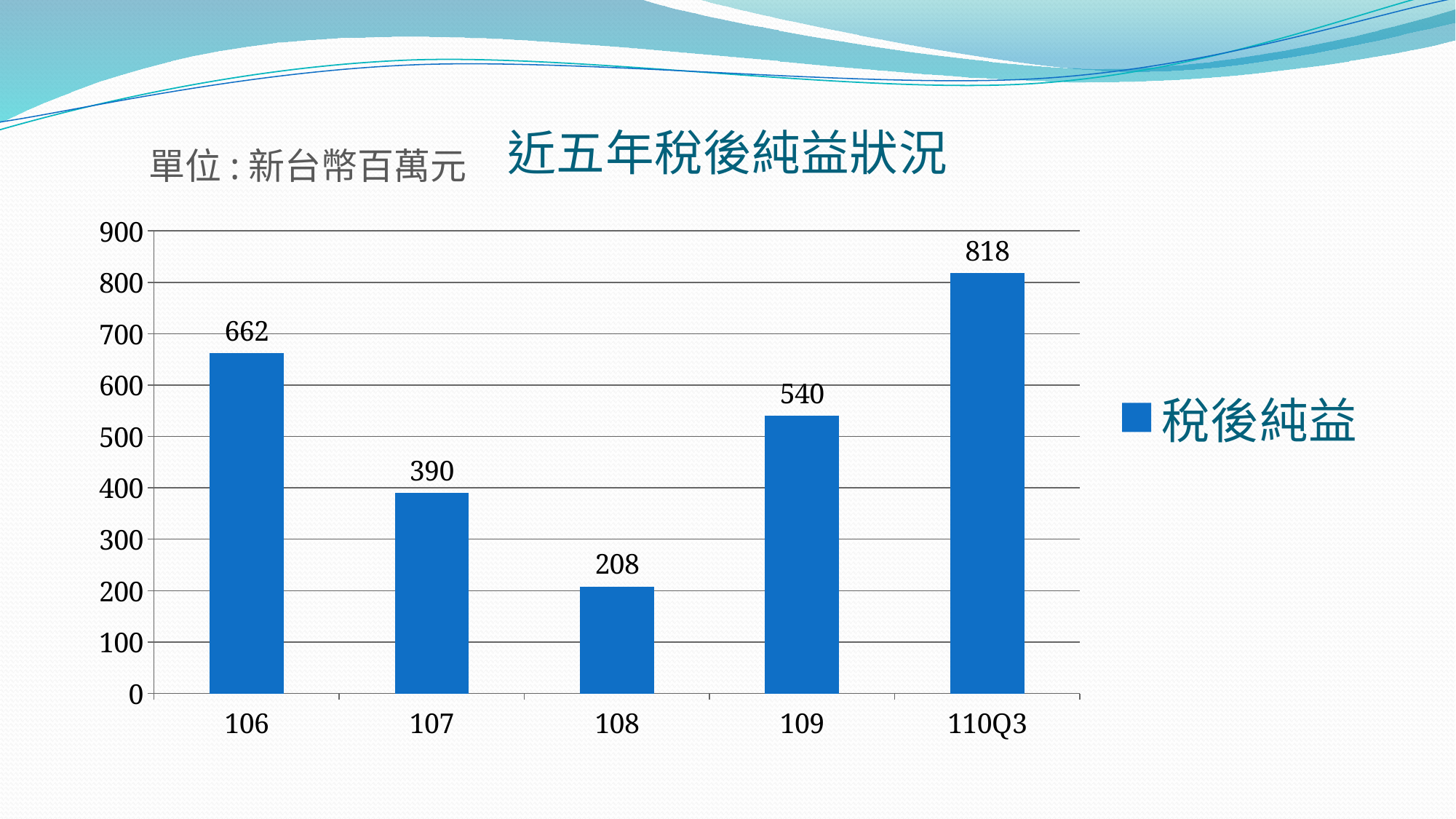
What is the value for 108? 208 Which is larger, the value for 107 or the value for 109? 109 What is the title of the chart? 近五年稅後純益狀況 What kind of chart is shown on the slide? bar chart Which category has the highest value? 110Q3 How many categories are shown on the x axis? 5 What is the difference between the values for 110Q3 and 106? 156 Is the value for 109 greater or less than 500? greater Which category has the lowest value? 108 What is the difference between the values for 109 and 107? 150 What is the value for 110Q3? 818 What is the value for 106? 662